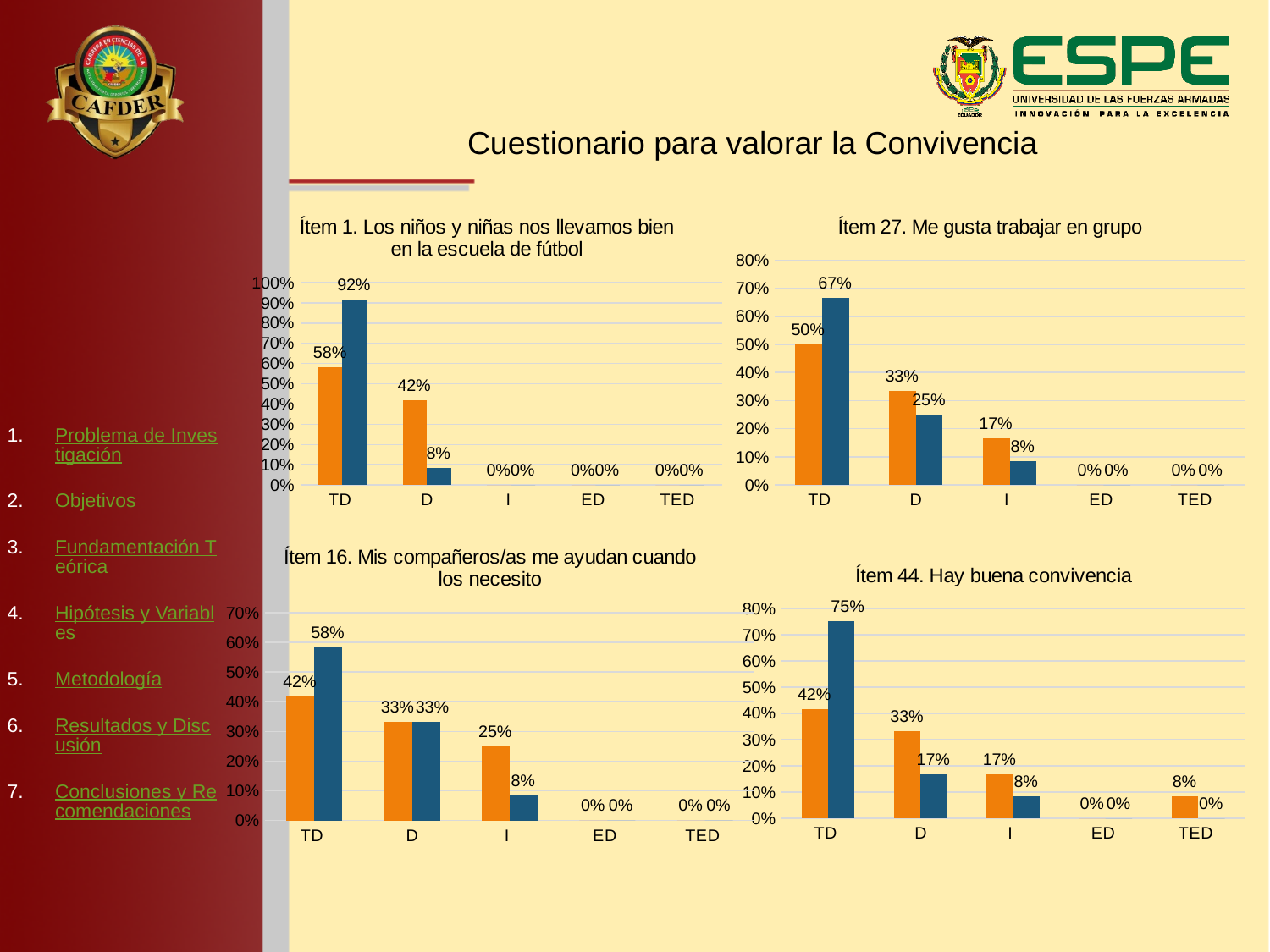
In the chart 'Ítem 16. Mis compañeros/as me ayudan cuando los necesito', what is the value of the orange bar for I? 25% In the chart 'Ítem 1. Los niños y niñas nos llevamos bien en la escuela de fútbol', what is the value of the blue bar for TD? 92% In the chart 'Ítem 44. Hay buena convivencia', what is the value of the blue bar for TD? 75% In the chart 'Ítem 27. Me gusta trabajar en grupo', which is larger for D, the orange bar or the blue bar? the orange bar In the chart 'Ítem 44. Hay buena convivencia', what is the value of the orange bar for TED? 8% How many categories are shown on the x axis of the chart 'Ítem 44. Hay buena convivencia'? 5 What type of chart is 'Ítem 16. Mis compañeros/as me ayudan cuando los necesito'? bar chart In the chart 'Ítem 27. Me gusta trabajar en grupo', what is the value of the orange bar for TD? 50% In the chart 'Ítem 1. Los niños y niñas nos llevamos bien en la escuela de fútbol', what is the difference between the blue and orange bars for TD? 34% In the chart 'Ítem 1. Los niños y niñas nos llevamos bien en la escuela de fútbol', what is the value of the orange bar for D? 42% In the chart 'Ítem 16. Mis compañeros/as me ayudan cuando los necesito', what is the difference between the blue bar for TD and the orange bar for TD? 16% In the chart 'Ítem 27. Me gusta trabajar en grupo', which category has the highest blue bar? TD